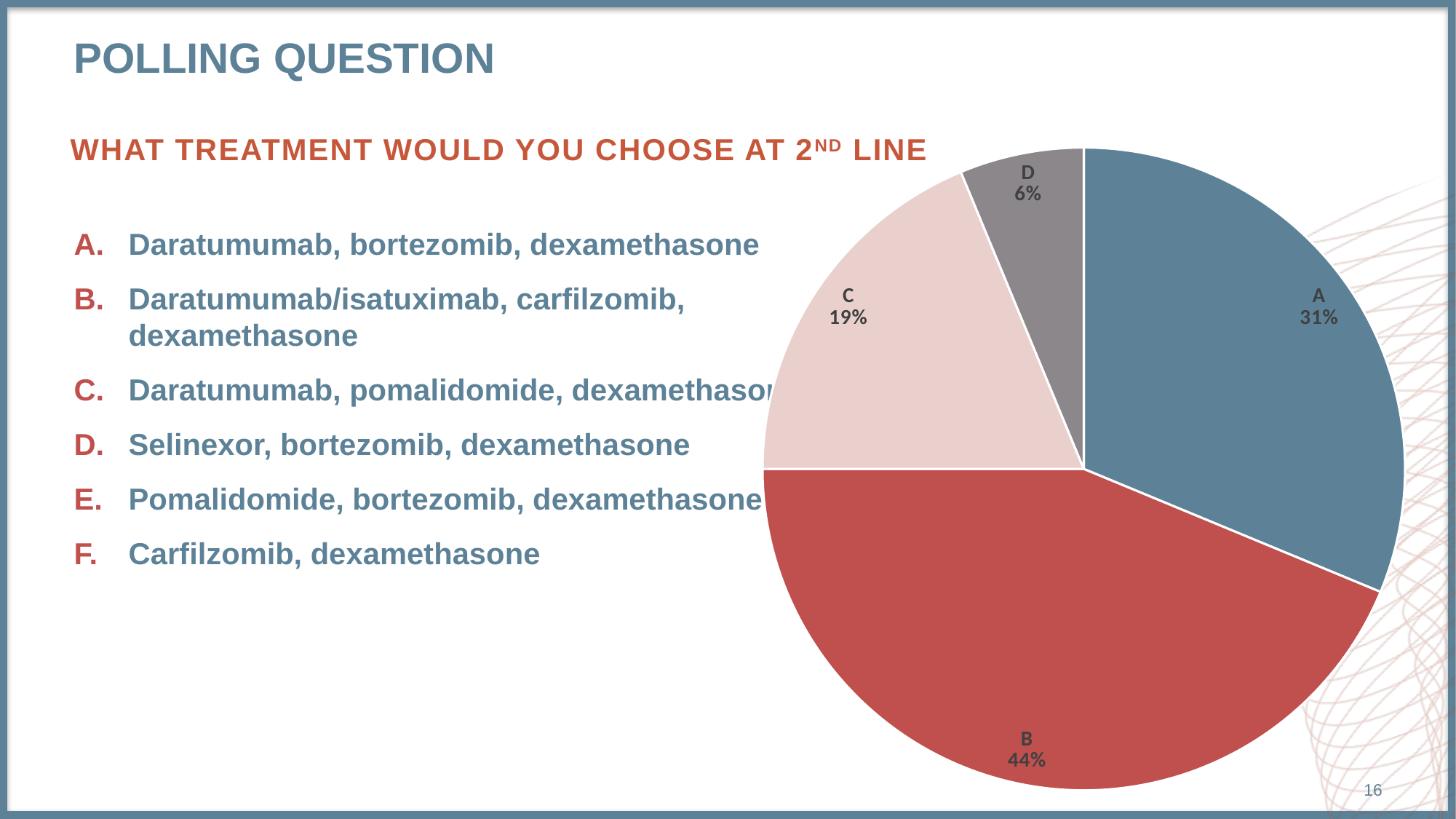
What share of the pie does option D have? 6% What colour is the slice for option B? red How many slices does the pie chart have? 4 Which is larger, the slice for option A or the slice for option C? A What share of the pie does option C have? 19% What is the difference in percentage points between option C and option D? 13 What kind of chart is shown on the slide? pie chart What share of the pie does option A have? 31% Which option has the largest slice of the pie? B What is the difference in percentage points between option B and option A? 13 Which option has the smallest slice of the pie? D